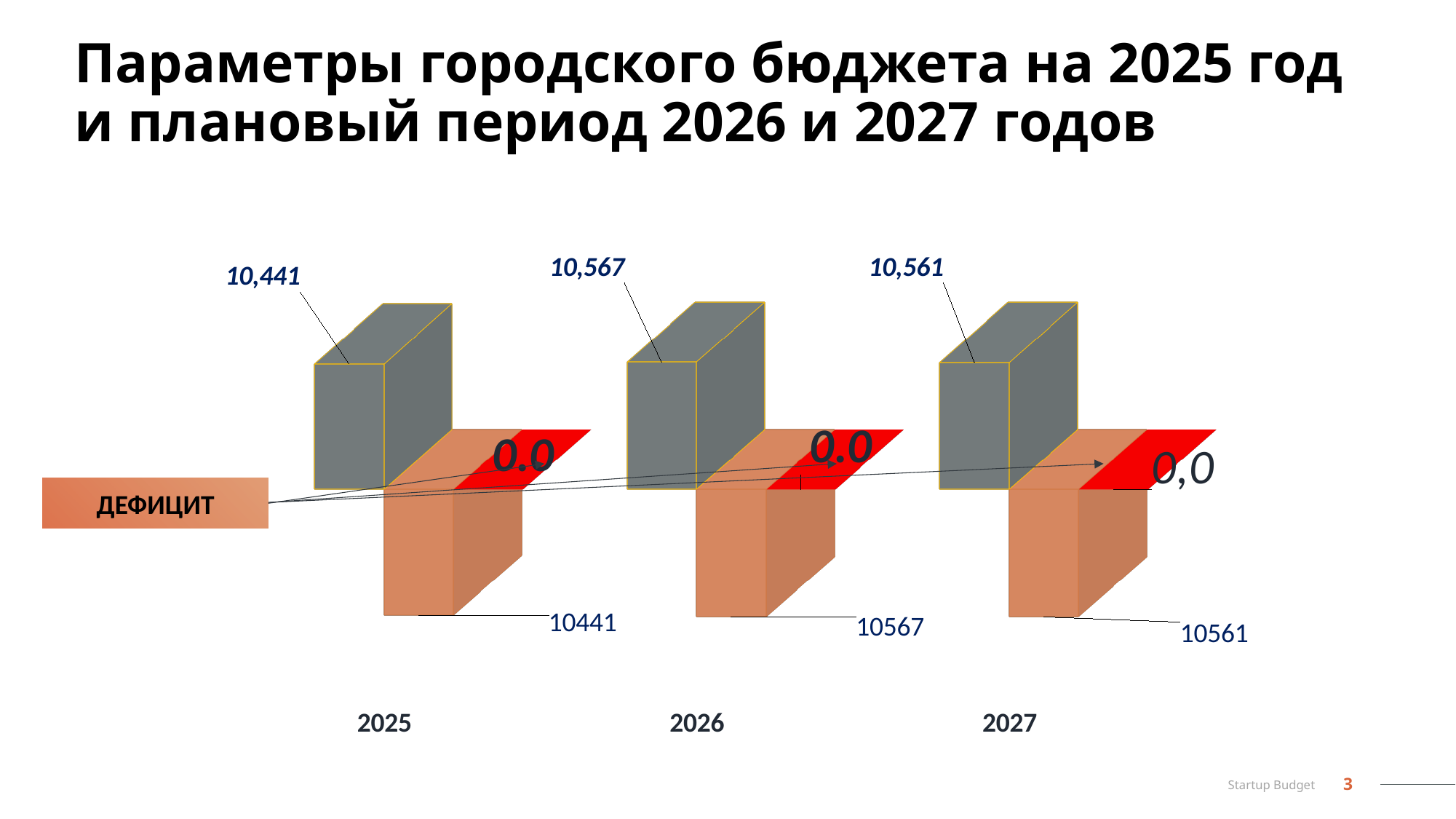
Which year has the lowest value for the gray bars? 2025 Is the gray bar value for 2026 larger or smaller than the gray bar value for 2025? larger How many years are shown on the x axis of the chart? 3 What is the value of the orange bar for 2027? 10561 Which year has the highest value for the gray bars? 2026 What is the value of the gray bar for 2026? 10,567 What is the value of the gray bar for 2025? 10,441 What is the value of the orange bar for 2025? 10441 What kind of chart is shown on the slide? bar chart What is the value of the gray bar for 2027? 10,561 What is the value of the ДЕФИЦИТ (red) series for 2025? 0.0 What is the difference between the gray bar values for 2026 and 2025? 126